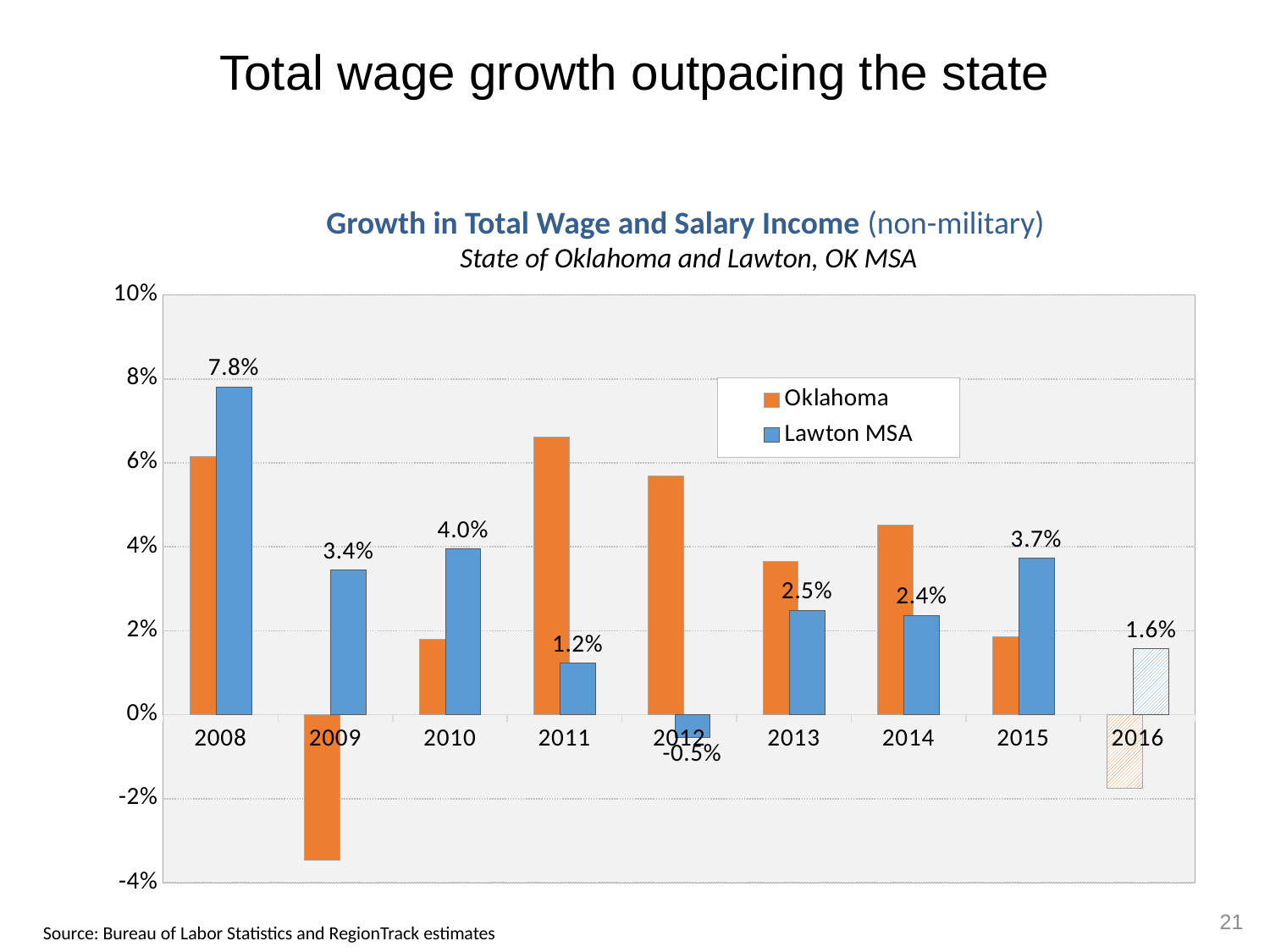
How many years are shown on the x axis? 9 What is the difference between the Lawton MSA values for 2008 and 2015? 4.1 percentage points In 2011, which is larger: the Oklahoma value or the Lawton MSA value? Oklahoma In which year is the Lawton MSA growth highest? 2008 Is the Oklahoma value for 2009 greater or less than -2%? less What kind of chart is shown on the slide? Bar chart What is the Lawton MSA growth value for 2012? -0.5% In which year is the Lawton MSA growth lowest? 2012 How many series does the legend list? 2 What is the Lawton MSA growth value for 2016? 1.6% What is the Lawton MSA growth value for 2008? 7.8% Is the Oklahoma value for 2011 greater or less than 6%? greater